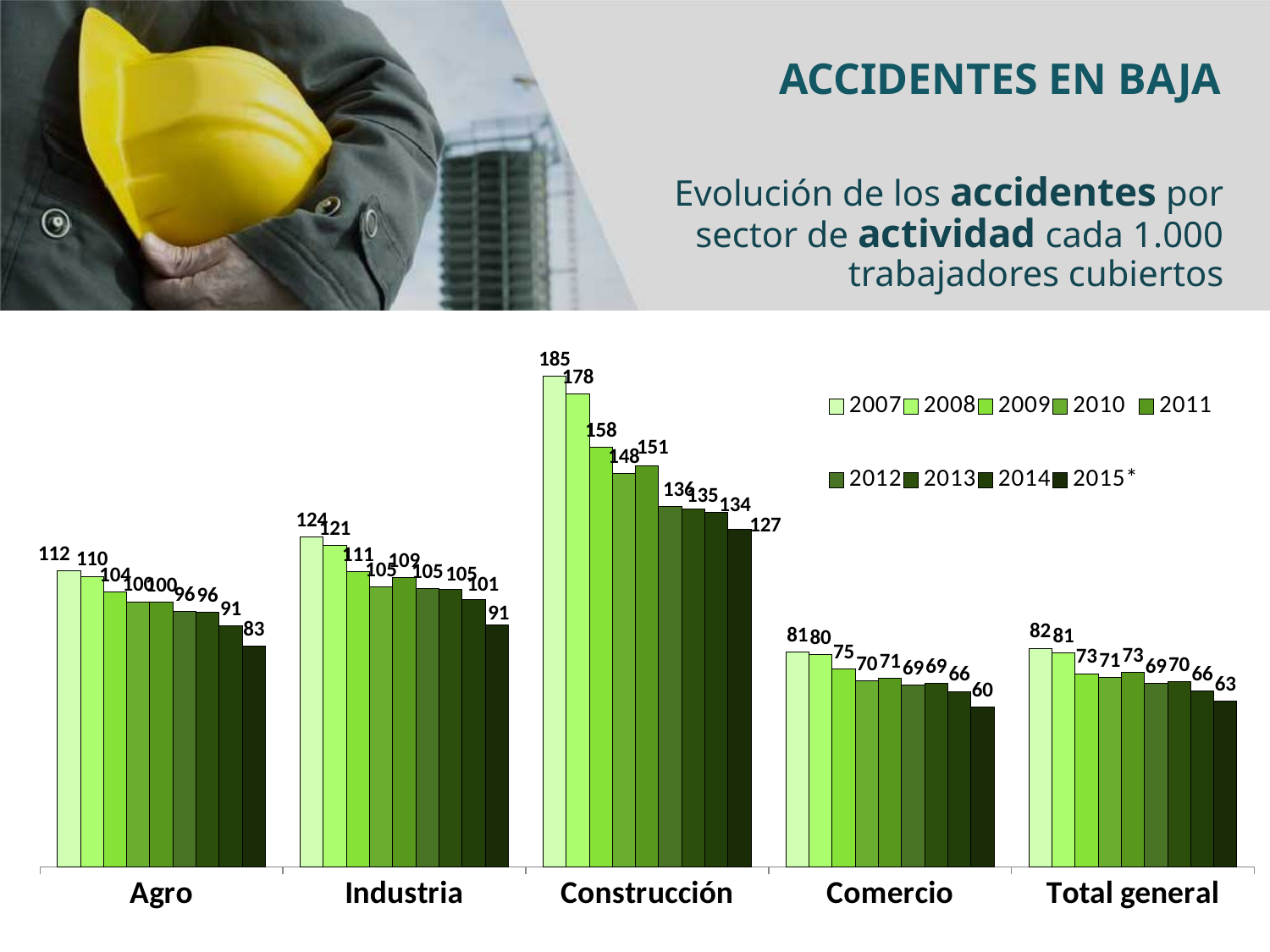
How many series (years) does the chart legend list? 9 What is the value for Agro in 2015*? 83 What is the value for Total general in 2007? 82 Which sector has the highest value in 2007? Construcción What is the value for Construcción in 2007? 185 What kind of chart is shown on the slide? bar chart Which is larger, the 2007 value for Industria or the 2007 value for Agro? Industria How many sector categories are shown on the x axis of the chart? 5 Which sector has the lowest value in 2015*? Comercio Do the values for Construcción rise or fall from 2007 to 2015*? fall What is the difference between the Construcción values for 2007 and 2015*? 58 What is the value for Comercio in 2015*? 60